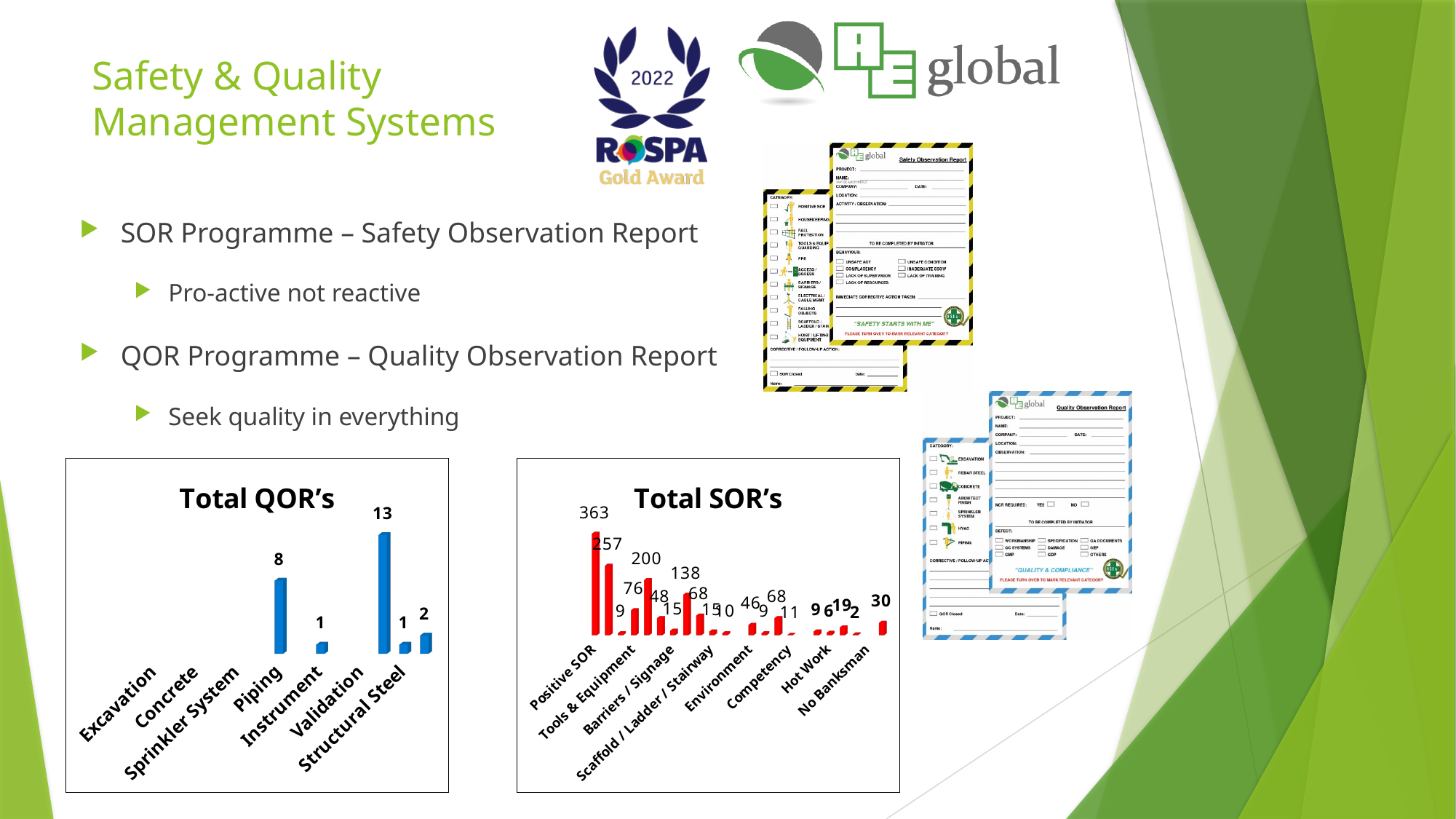
In the Total SOR's chart, what is the difference between the two largest values, 363 and 257? 106 In the Total QOR's chart, what is the value for Piping? 8 In the Total QOR's chart, what is the highest value shown? 13 In the Total SOR's chart, what is the lowest value shown? 2 What kind of chart is the Total SOR's chart? bar chart What is the title of the chart on the right? Total SOR's What is the title of the chart on the left? Total QOR's In the Total QOR's chart, which is larger, the value for Piping or the highest bar labelled 13? the bar labelled 13 What kind of chart is the Total QOR's chart? bar chart In the Total SOR's chart, what is the value for Positive SOR? 363 In the Total SOR's chart, which category has the highest value? Positive SOR